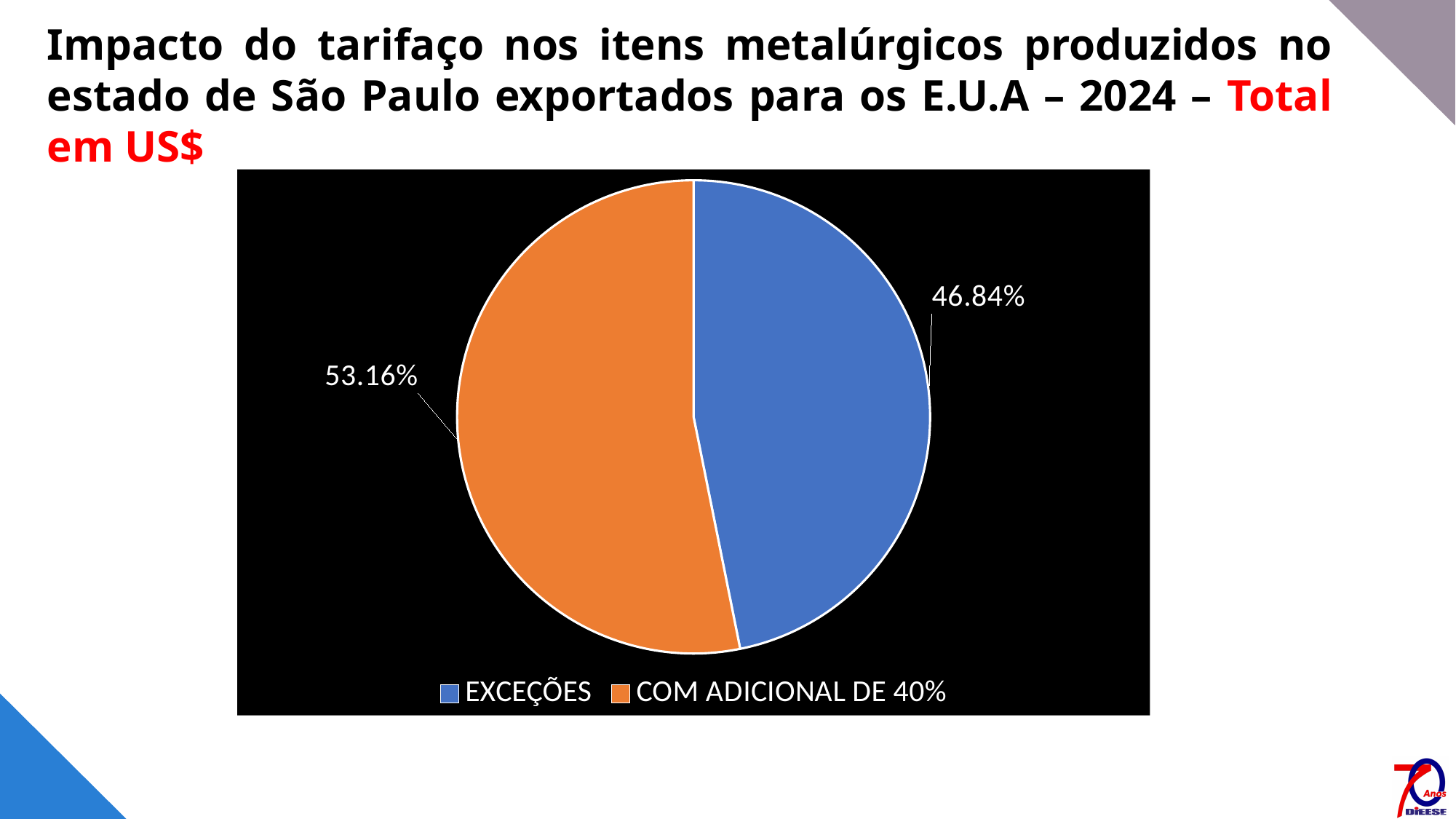
What kind of chart is shown on the slide? pie chart How many categories are shown in the pie chart? 2 What is the difference in percentage points between the COM ADICIONAL DE 40% slice and the EXCEÇÕES slice? 6.32 Is the share for EXCEÇÕES greater or less than 50%? less What share of the pie does EXCEÇÕES represent? 46.84% What colour is the COM ADICIONAL DE 40% slice? orange Which is larger, the EXCEÇÕES slice or the COM ADICIONAL DE 40% slice? COM ADICIONAL DE 40% What is the total of the two slice percentages shown? 100% Which category has the smallest slice of the pie? EXCEÇÕES Which category has the largest slice of the pie? COM ADICIONAL DE 40% What share of the pie does COM ADICIONAL DE 40% represent? 53.16% What colour is the EXCEÇÕES slice? blue